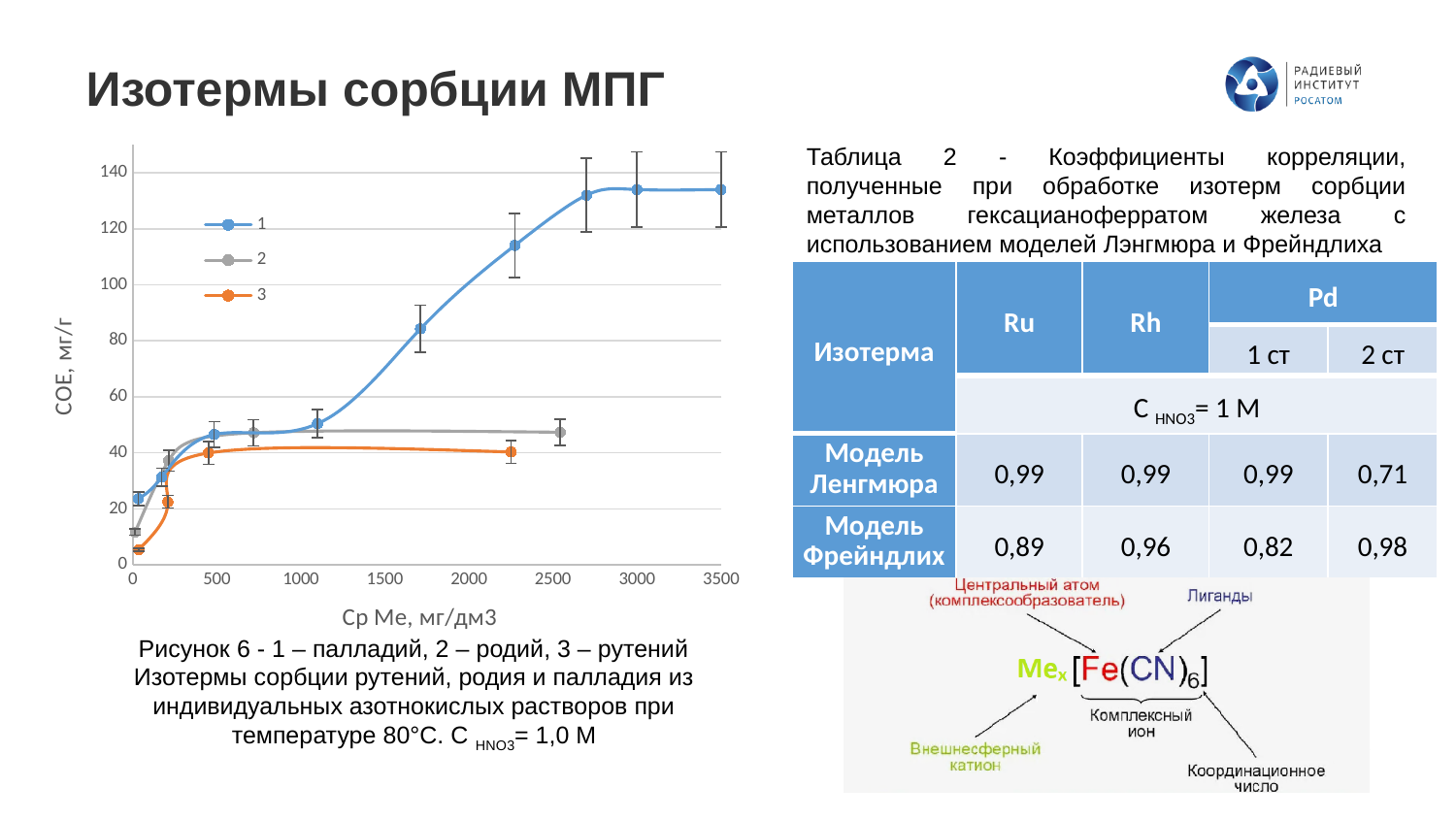
Is the value for series 1 at Ср Ме = 3000 мг/дм3 greater or less than 120? greater Is the value for series 2 at Ср Ме = 2500 мг/дм3 greater or less than 60? less Is the value for series 1 at Ср Ме = 1700 мг/дм3 greater or less than 60? greater What are the legend entries of the chart? 1, 2, 3 What kind of chart is shown on the slide? Line chart Does the value of series 1 rise or fall as Ср Ме increases from 0 to 3000 мг/дм3? Rises How many series does the chart legend list? 3 Which series reaches the highest value on the chart? 1 At Ср Ме ≈ 2250 мг/дм3, which series has the larger value, series 1 or series 3? Series 1 Which series has the lowest values at the right end of its curve? 3 What is the title of the vertical axis of the chart? СОЕ, мг/г